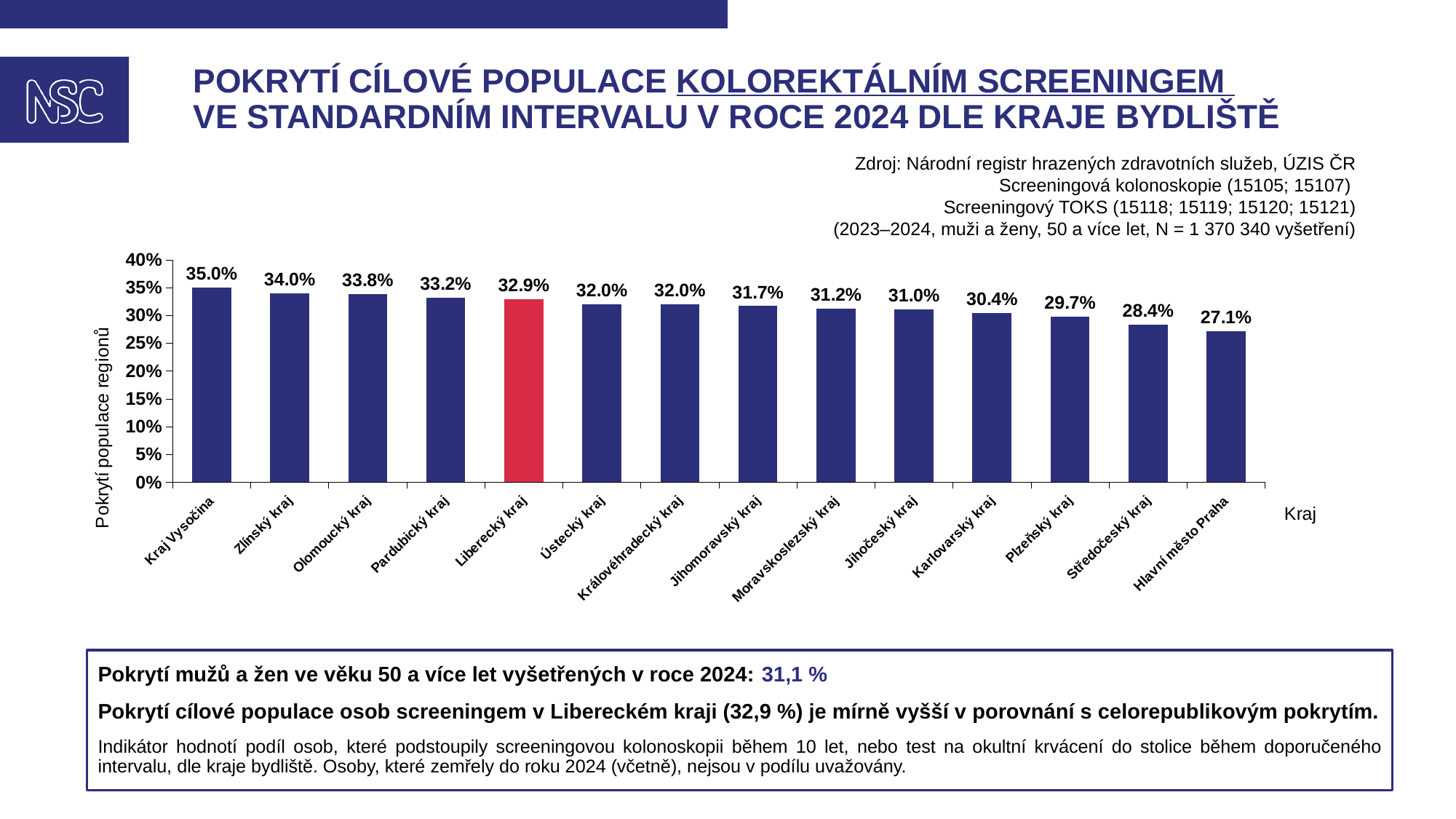
Which bar is highlighted in red? Liberecký kraj Is the value for Karlovarský kraj greater or less than 35%? less What is the value for Liberecký kraj? 32.9% Which region has the lowest value? Hlavní město Praha What is the difference between the values for Kraj Vysočina and Hlavní město Praha? 7.9% What is the value for Hlavní město Praha? 27.1% Which is larger, the value for Zlínský kraj or the value for Plzeňský kraj? Zlínský kraj Which region has the highest value? Kraj Vysočina What is the value for Jihomoravský kraj? 31.7% How many regions are shown on the x axis? 14 What kind of chart is shown on the slide? bar chart What is the difference between the values for Liberecký kraj and Středočeský kraj? 4.5%